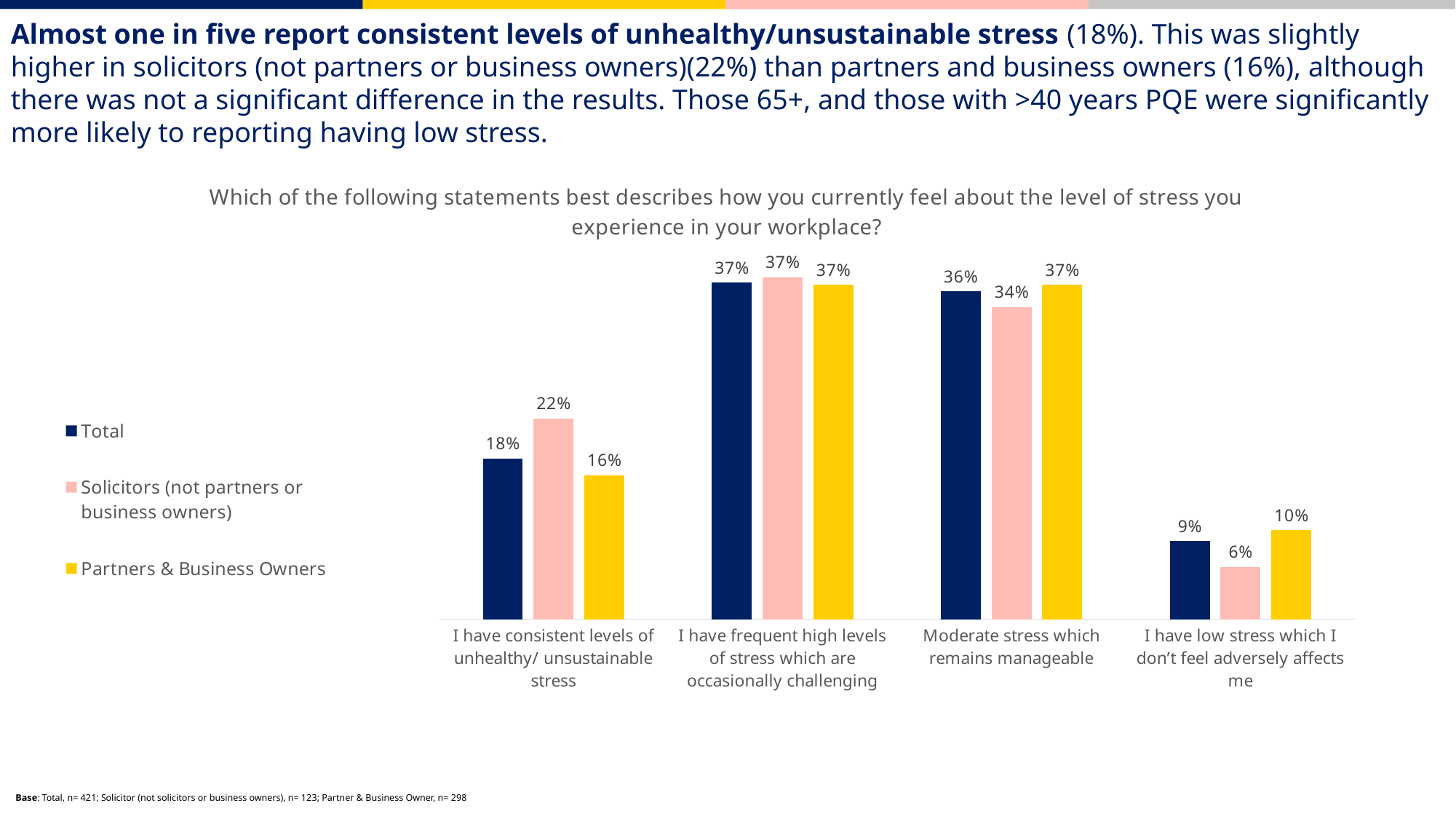
What is the difference between the Total value and the Solicitors (not partners or business owners) value for "I have low stress which I don't feel adversely affects me"? 3% Which category has the lowest value for Solicitors (not partners or business owners)? I have low stress which I don't feel adversely affects me What is the value for Solicitors (not partners or business owners) for "Moderate stress which remains manageable"? 34% What kind of chart is shown on the slide? Bar chart For "Moderate stress which remains manageable", which is larger: the Total value or the Solicitors (not partners or business owners) value? Total How many categories are shown on the x axis? 4 What is the difference between the Solicitors (not partners or business owners) value and the Partners & Business Owners value for "I have consistent levels of unhealthy/ unsustainable stress"? 6% What is the Total value for "I have consistent levels of unhealthy/ unsustainable stress"? 18% What is the value for Partners & Business Owners for "I have low stress which I don't feel adversely affects me"? 10% Which category has the highest Total value? I have frequent high levels of stress which are occasionally challenging Which colour represents Partners & Business Owners in the chart? Yellow How many series does the legend list? 3